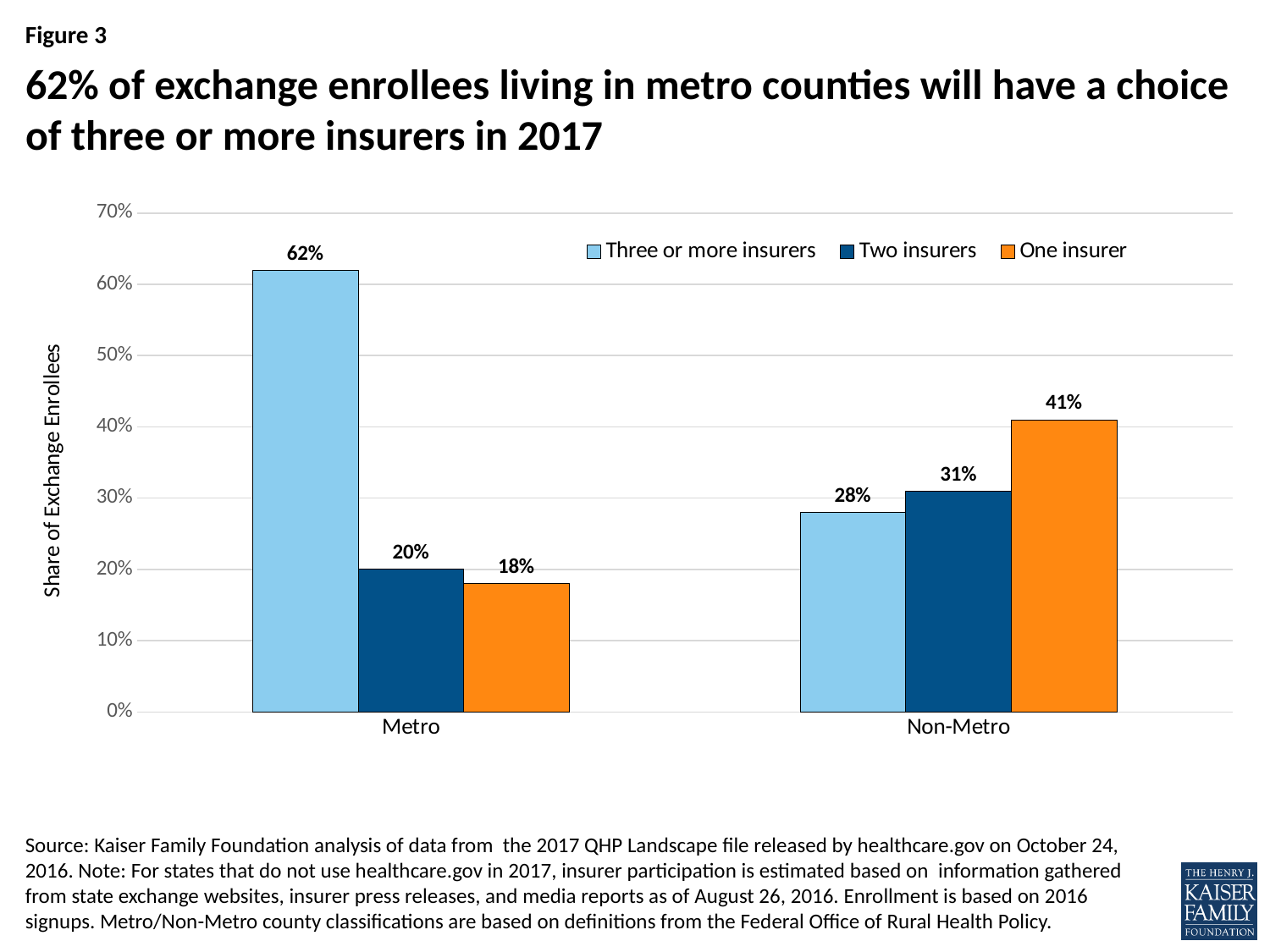
Which insurer-choice category has the lowest share among Non-Metro enrollees? Three or more insurers What is the value for One insurer in Metro counties? 18% What is the difference between the Three or more insurers share in Metro and in Non-Metro counties? 34 percentage points Is the value for One insurer in Non-Metro counties greater or less than 40%? greater How many county categories are shown on the x axis? 2 Which insurer-choice category has the highest share among Metro enrollees? Three or more insurers Which is larger: the Two insurers share in Metro or in Non-Metro counties? Non-Metro How many series does the legend list? 3 What share of exchange enrollees in Non-Metro counties have only one insurer? 41% What is the value for Two insurers in Non-Metro counties? 31% What type of chart is shown on the slide? Bar chart What share of exchange enrollees in Metro counties have a choice of three or more insurers? 62%